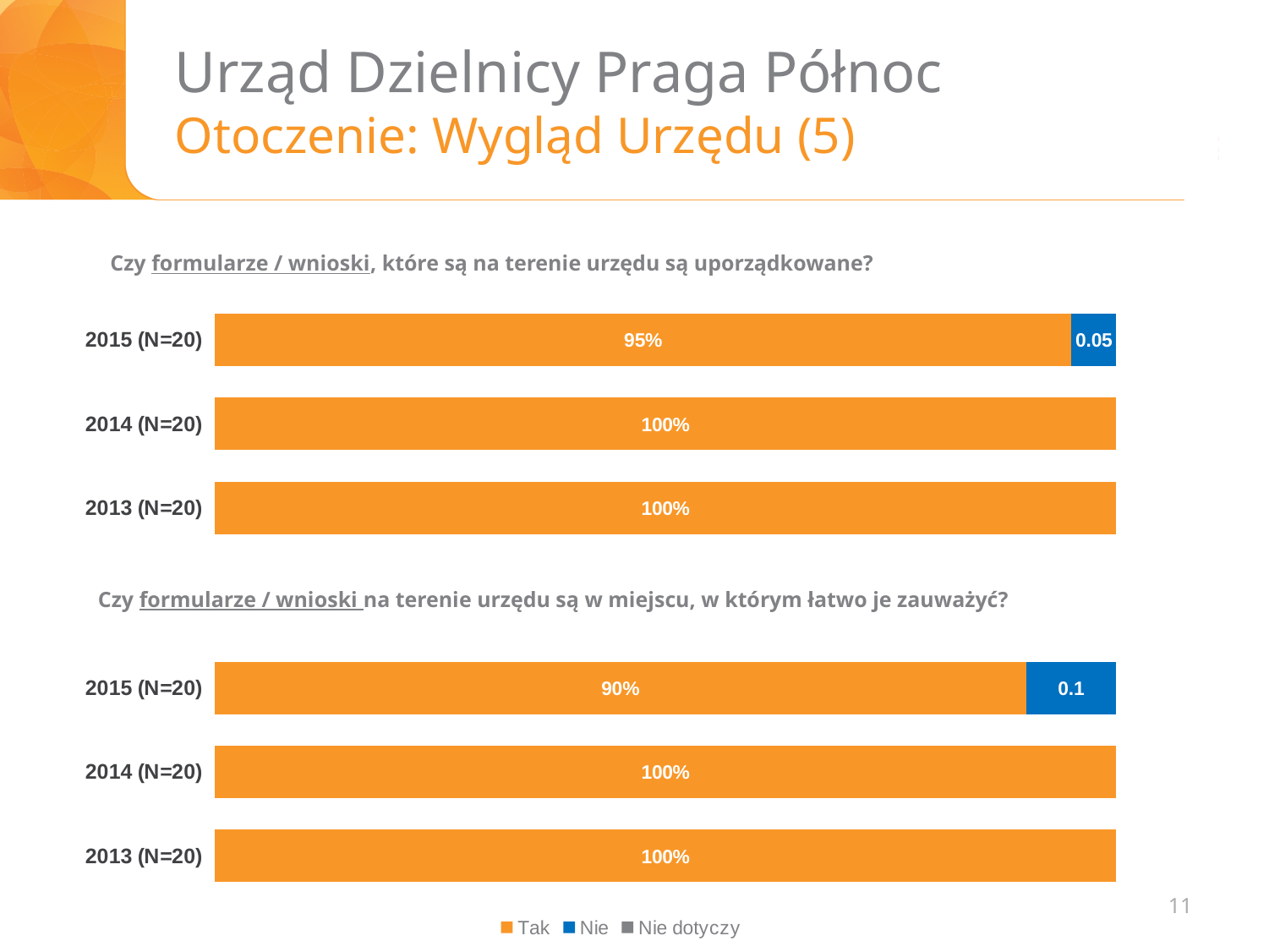
In the top chart ("Czy formularze / wnioski, które są na terenie urzędu są uporządkowane?"), what is the "Tak" value for 2015 (N=20)? 95% In the bottom chart ("Czy formularze / wnioski na terenie urzędu są w miejscu, w którym łatwo je zauważyć?"), what is the difference between the "Tak" values for 2014 (N=20) and 2015 (N=20)? 10% In the top chart ("Czy formularze / wnioski, które są na terenie urzędu są uporządkowane?"), what is the "Tak" value for 2014 (N=20)? 100% In the bottom chart ("Czy formularze / wnioski na terenie urzędu są w miejscu, w którym łatwo je zauważyć?"), what is the "Tak" value for 2015 (N=20)? 90% In the top chart ("Czy formularze / wnioski, które są na terenie urzędu są uporządkowane?"), what is the "Nie" value for 2015 (N=20)? 0.05 Is the "Tak" value for 2015 (N=20) larger in the top chart or in the bottom chart? Top chart In the top chart ("Czy formularze / wnioski, które są na terenie urzędu są uporządkowane?"), which year has the lowest "Tak" value? 2015 (N=20) How many series does the legend at the bottom of the slide list? 3 In the bottom chart ("Czy formularze / wnioski na terenie urzędu są w miejscu, w którym łatwo je zauważyć?"), what is the "Tak" value for 2013 (N=20)? 100% How many year categories does the top chart ("Czy formularze / wnioski, które są na terenie urzędu są uporządkowane?") show? 3 In the bottom chart ("Czy formularze / wnioski na terenie urzędu są w miejscu, w którym łatwo je zauważyć?"), which year has the lowest "Tak" value? 2015 (N=20) In the bottom chart ("Czy formularze / wnioski na terenie urzędu są w miejscu, w którym łatwo je zauważyć?"), what is the "Nie" value for 2015 (N=20)? 0.1